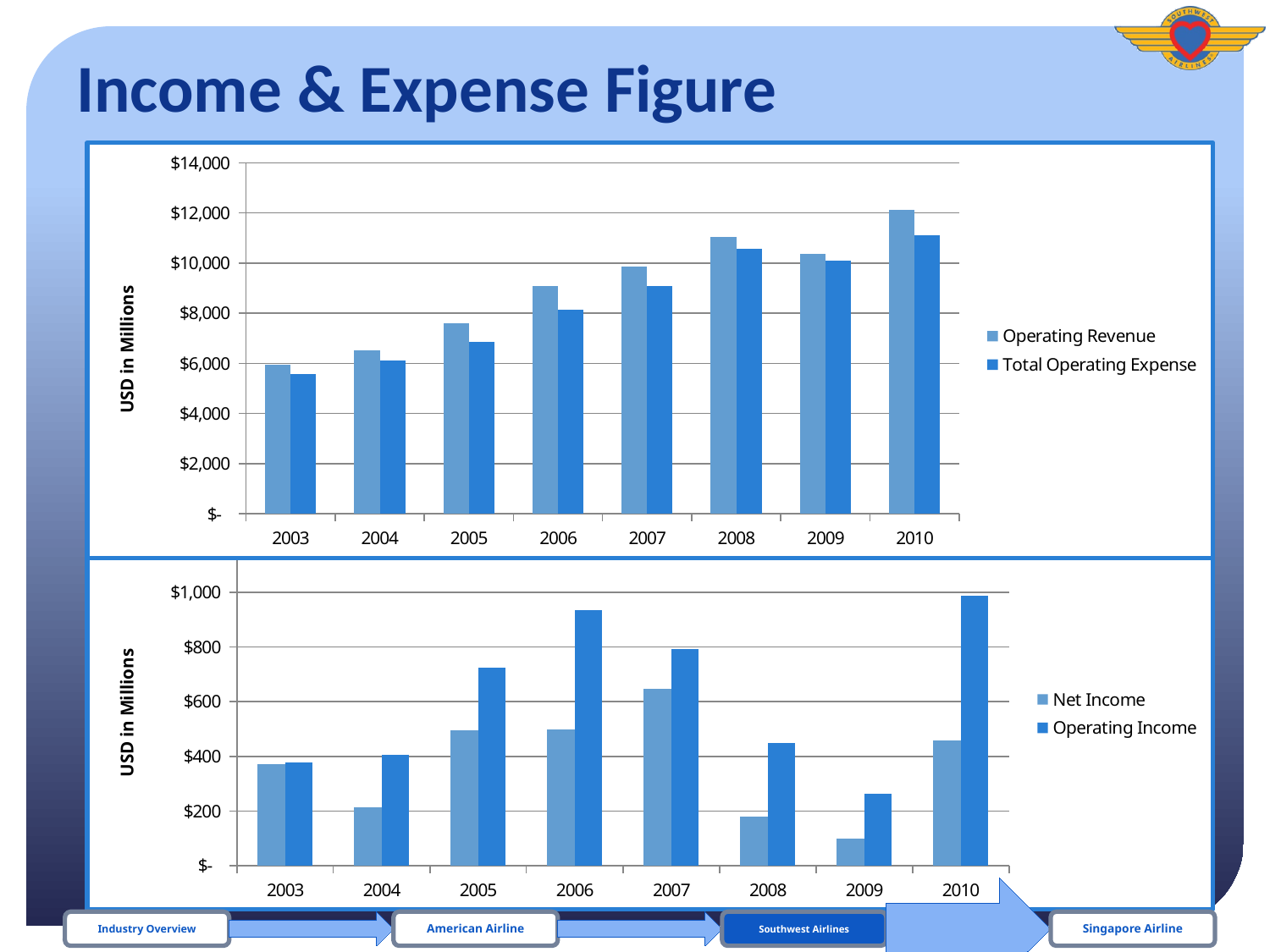
How many series does the legend of the top chart list? 2 In the top chart, is the Operating Revenue for 2005 greater or less than $8,000? less In the top chart, is the Operating Revenue for 2008 greater or less than $10,000? greater In the bottom chart, is the Operating Income for 2006 greater or less than $800? greater In the top chart, which year has the highest Operating Revenue? 2010 In the bottom chart, which is larger for 2006: Net Income or Operating Income? Operating Income In the bottom chart, which year has the highest Operating Income? 2010 What is the y-axis label of the bottom chart? USD in Millions In the top chart, which year has the lowest Total Operating Expense? 2003 What type of chart is the top chart on the slide? bar chart How many years are shown on the x axis of the bottom chart? 8 In the bottom chart, which year has the lowest Net Income? 2009